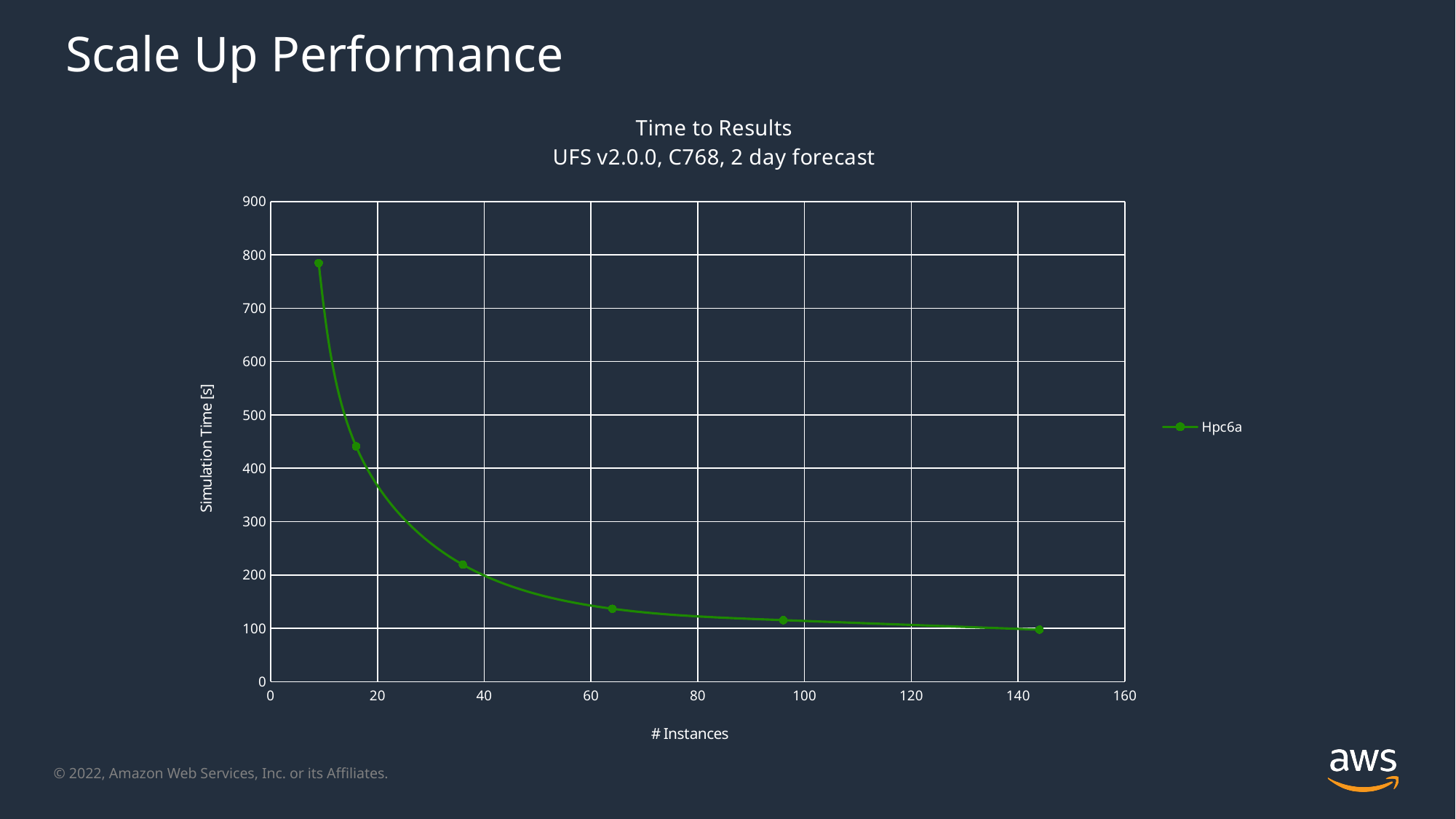
Is the simulation time for the leftmost data point greater or less than 700? greater What kind of chart is shown on the slide? line chart What is the label of the y axis? Simulation Time [s] Is the simulation time for the second data point from the left greater or less than 500? less Which data point has the highest simulation time, the leftmost or the rightmost? leftmost Is the simulation time for the third data point from the left greater or less than 300? less Does the simulation time rise or fall as the number of instances increases? fall How many series does the legend list? 1 What is the name of the series shown in the legend? Hpc6a What is the maximum value shown on the x axis? 160 How many data points are plotted on the Hpc6a line? 6